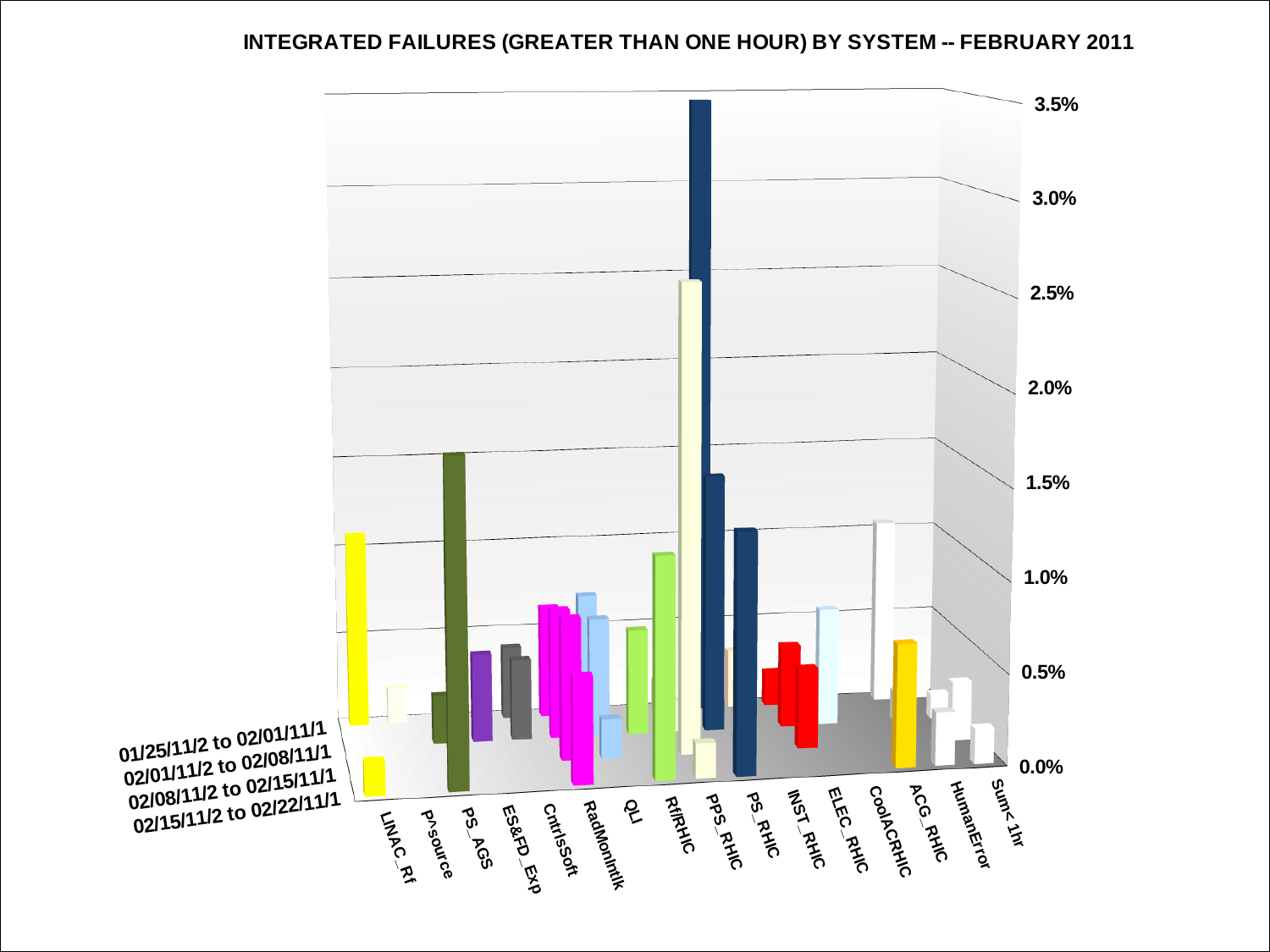
What kind of chart is shown on the slide? bar chart Is the tallest bar for ES&FD_Exp greater or less than 1.5%? less Which has a taller bar, PPS_RHIC or ELEC_RHIC? PPS_RHIC What is the title of the chart? INTEGRATED FAILURES (GREATER THAN ONE HOUR) BY SYSTEM -- FEBRUARY 2011 Which has a taller bar, PS_AGS or Sum<1hr? PS_AGS Is the tallest bar for PS_AGS greater or less than 1.0%? greater Is the tallest bar for PPS_RHIC greater or less than 3.0%? less Which system has the tallest bar in the chart? PS_RHIC What is the highest value shown on the vertical axis? 3.5% How many system categories are shown along the x axis? 16 How many date-range series are plotted in the chart? 4